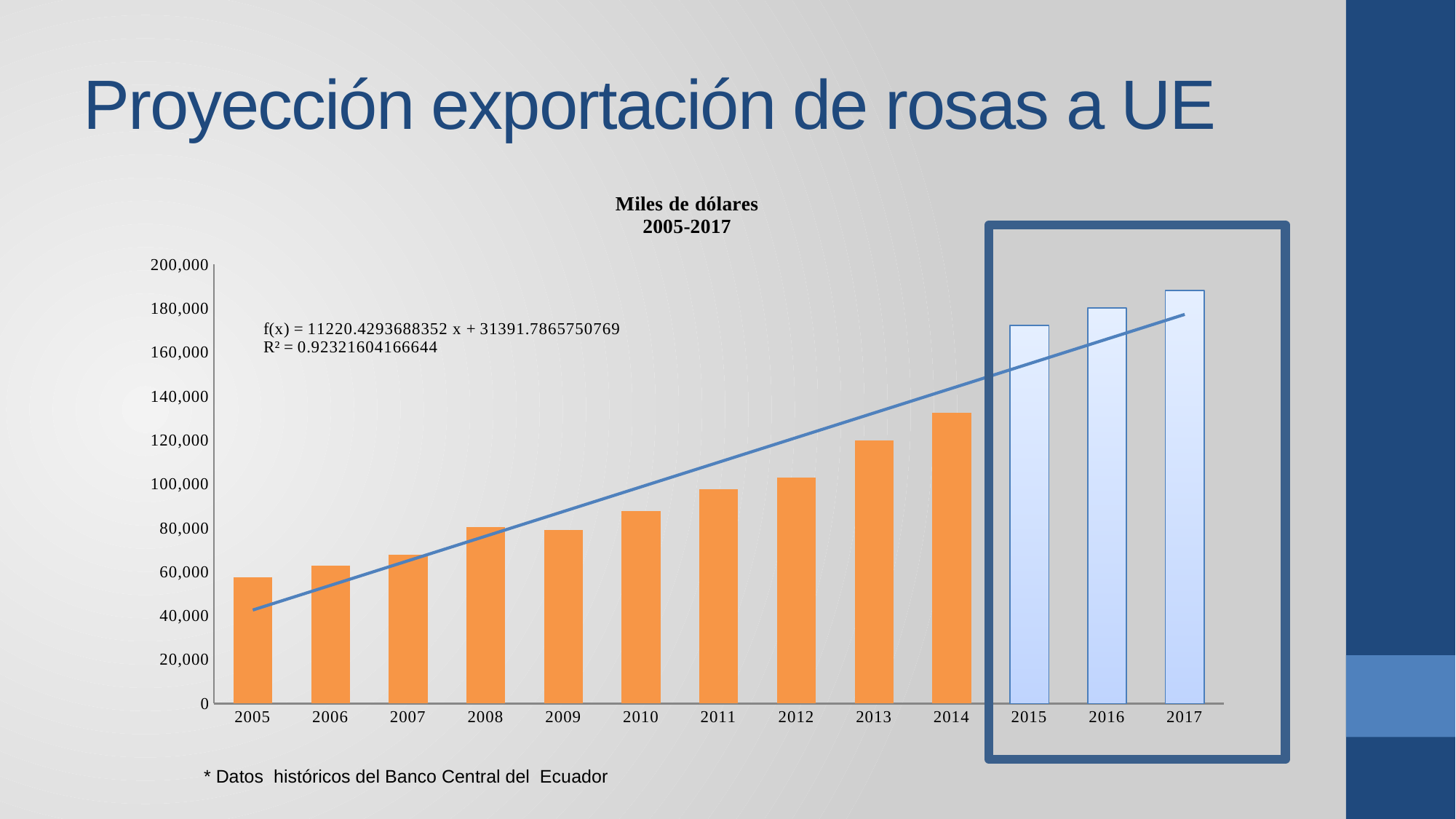
Is the value for 2017 greater or less than 180,000? greater What is the title of the chart? Miles de dólares 2005-2017 Do the bar values generally rise or fall from 2005 to 2017? rise What kind of chart is shown on the slide? bar chart Which year has the lowest bar in the chart? 2005 What R² value is printed on the chart for the trendline? 0.92321604166644 Which year has the highest bar in the chart? 2017 How many years are plotted on the x axis of the chart? 13 Which year has the larger value, 2013 or 2014? 2014 Is the value for 2014 greater or less than 120,000? greater Is the value for 2010 greater or less than 80,000? greater